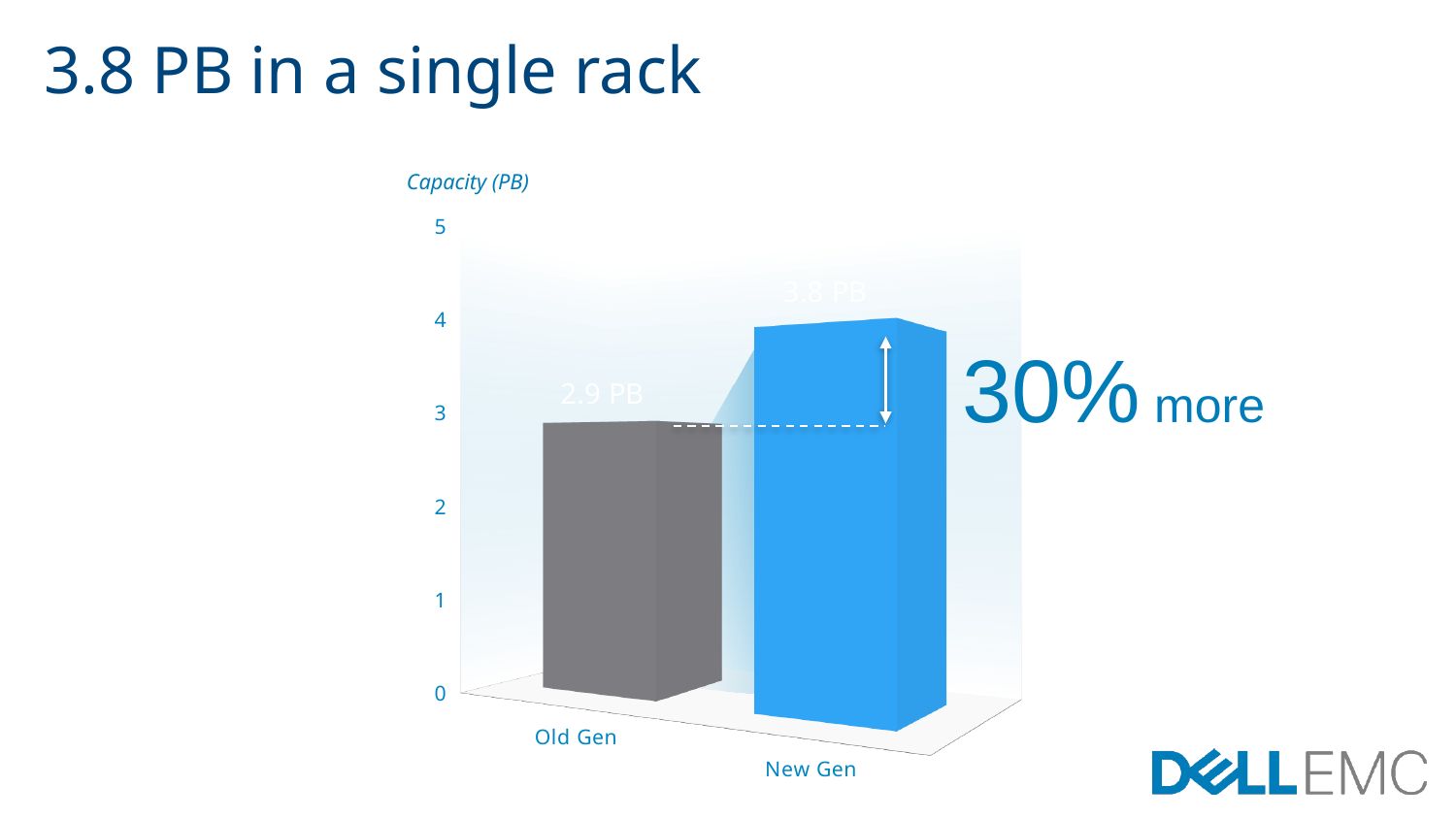
What is the label of the vertical axis? Capacity (PB) Which category has the higher capacity, Old Gen or New Gen? New Gen What is the capacity shown for New Gen? 3.8 PB What is the difference in capacity between New Gen and Old Gen? 0.9 PB How many categories are plotted on the chart? 2 Do the values rise or fall from Old Gen to New Gen? rise What is the capacity shown for Old Gen? 2.9 PB Is the value for Old Gen greater or less than 3? less What percentage increase does the annotation next to the New Gen bar state? 30% more What kind of chart is shown on the slide? bar chart Which category has the lowest capacity? Old Gen